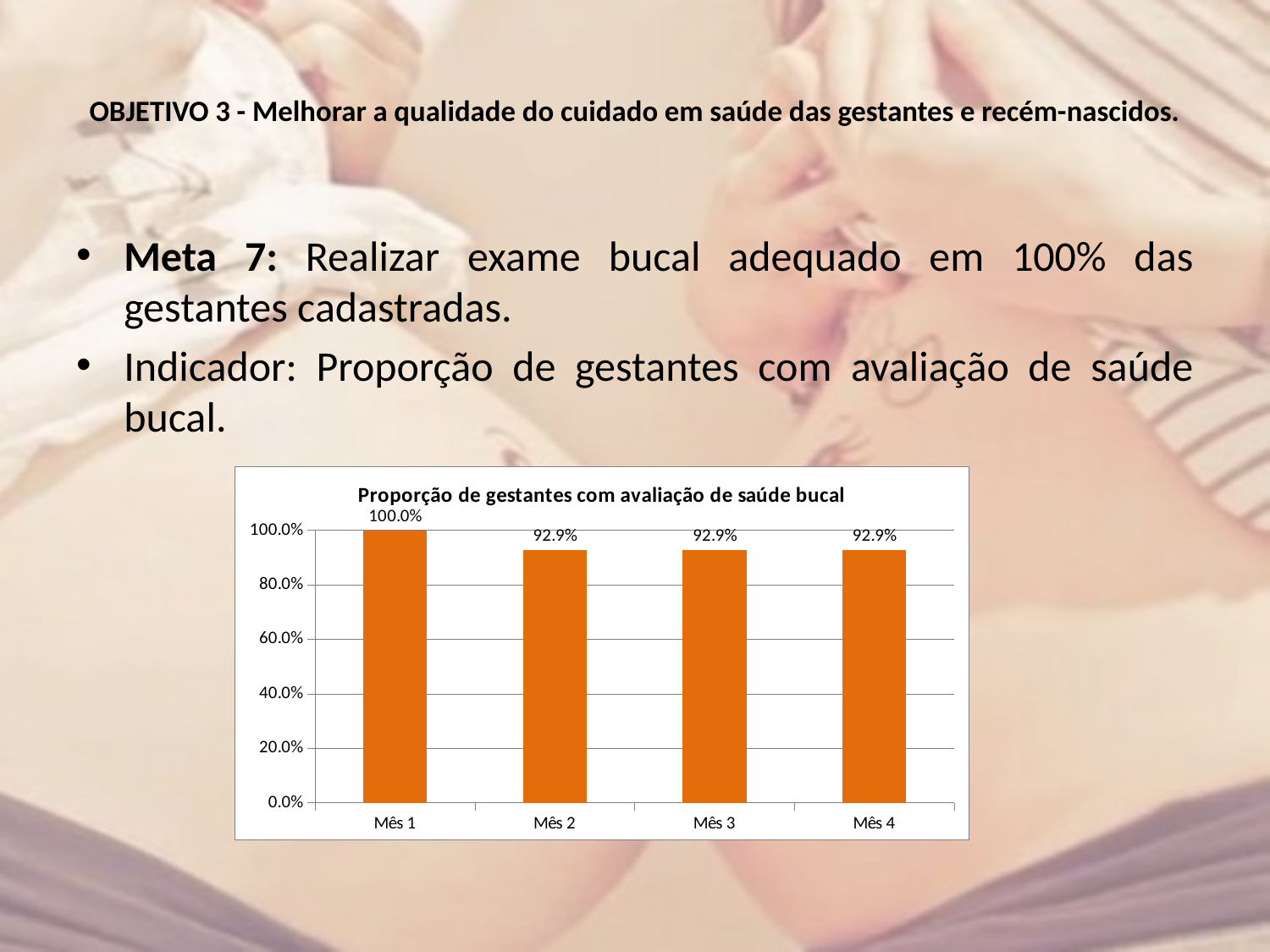
Is the value for Mês 3 greater or less than 80.0%? greater How many months are shown on the x axis? 4 What is the value for Mês 2? 92.9% Which month has the highest value? Mês 1 What is the value for Mês 4? 92.9% What kind of chart is shown? bar chart Do the values rise or fall from Mês 1 to Mês 2? fall What is the title of the chart? Proporção de gestantes com avaliação de saúde bucal What is the difference between the values for Mês 1 and Mês 3? 7.1% What is the value for Mês 1? 100.0% What colour are the bars in the chart? orange Which is larger, the value for Mês 1 or the value for Mês 2? Mês 1